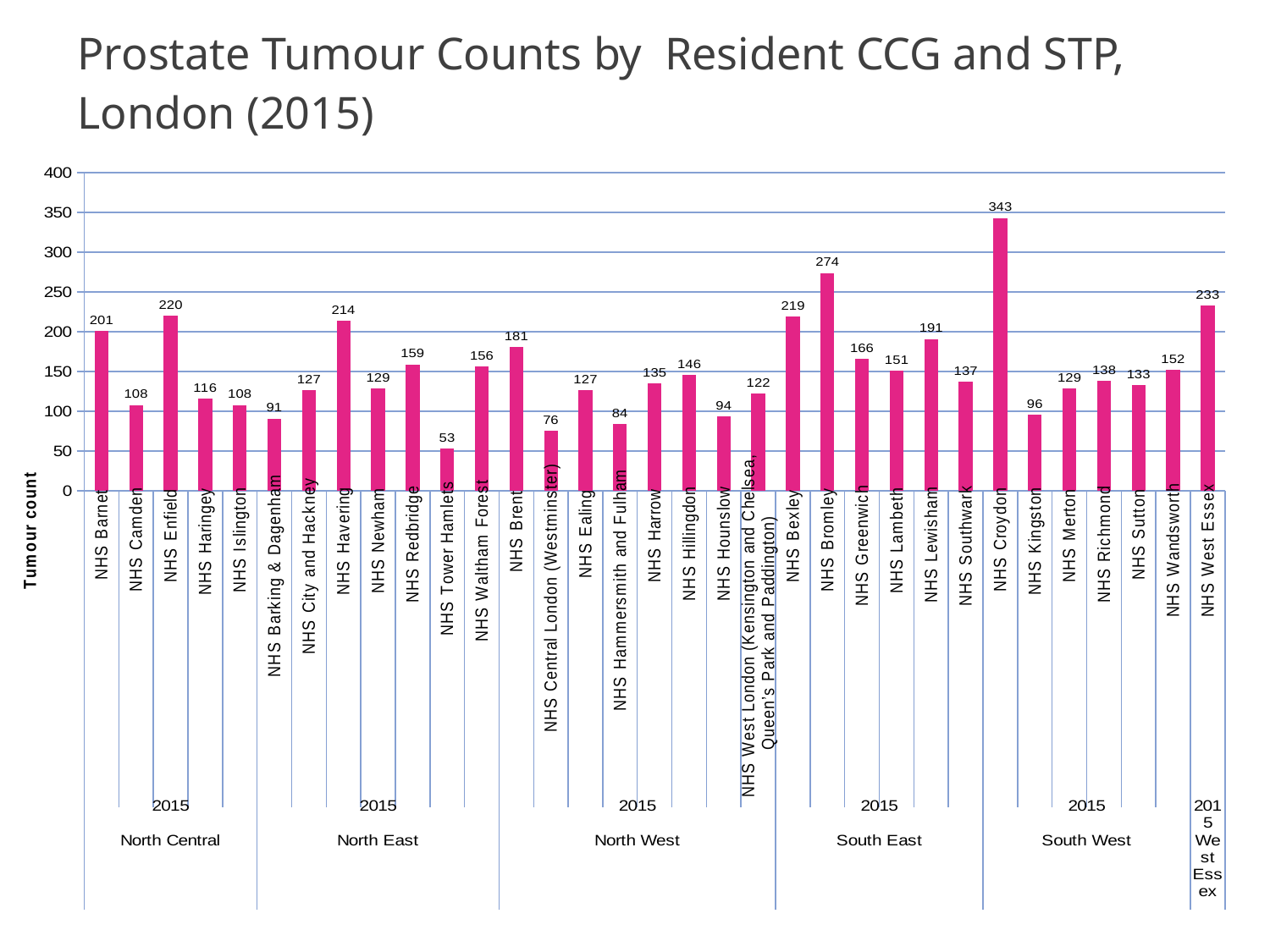
Which CCG has the highest tumour count? NHS Croydon What is the tumour count for NHS Bromley? 274 How many CCG bars are plotted on the chart? 33 What kind of chart is shown on the slide? Bar chart What is the difference between the tumour counts for NHS Enfield and NHS Camden? 112 What is the tumour count for NHS Croydon? 343 What is the label on the vertical axis of the chart? Tumour count Which has a higher tumour count, NHS Havering or NHS Bexley? NHS Bexley What is the difference between the tumour counts for NHS Croydon and NHS Kingston? 247 Is the value for NHS West Essex greater or less than 200? greater Which CCG has the lowest tumour count? NHS Tower Hamlets What is the tumour count for NHS Tower Hamlets? 53